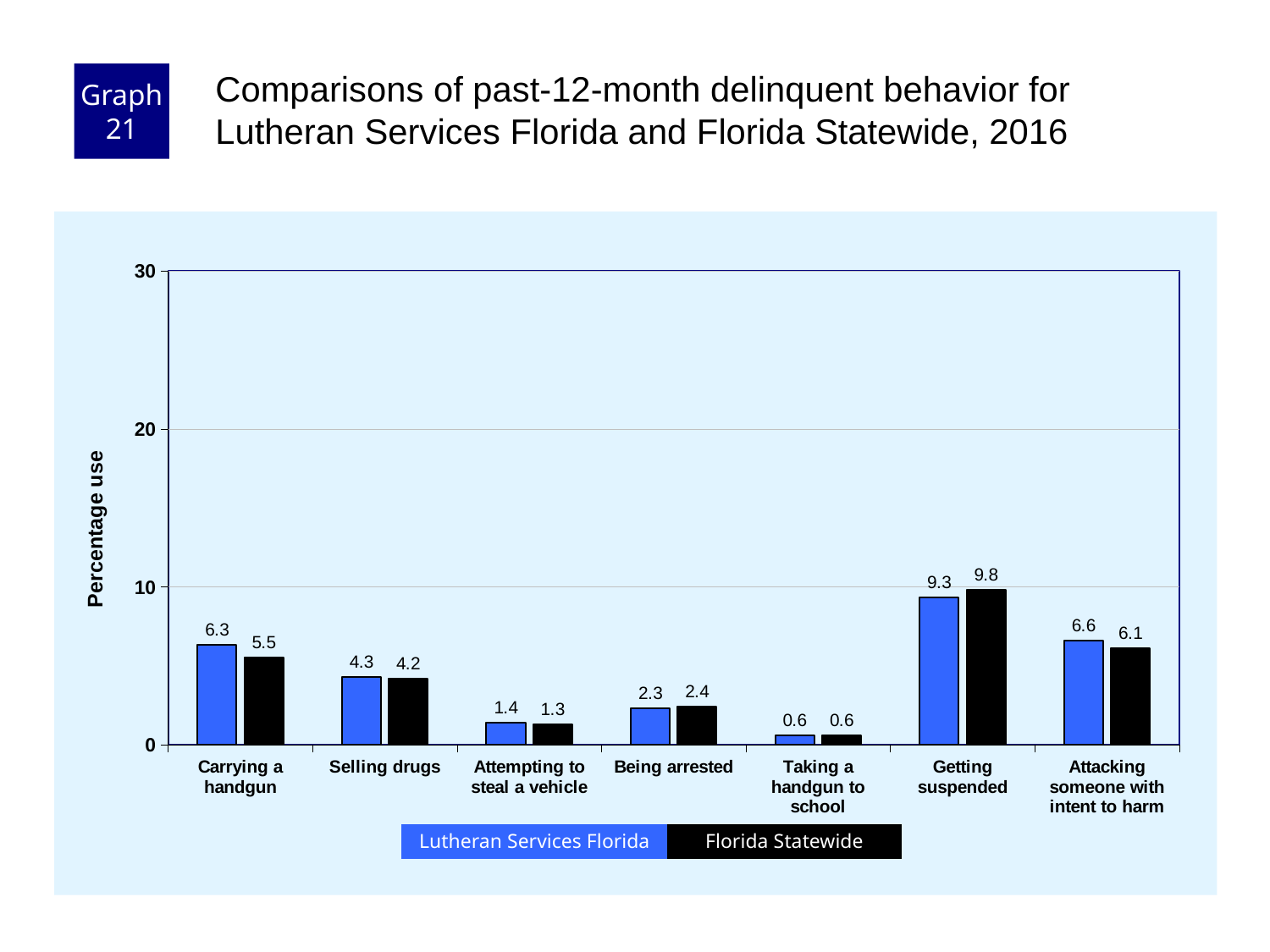
For Attacking someone with intent to harm, which is larger: Lutheran Services Florida or Florida Statewide? Lutheran Services Florida How many series does the legend list? 2 What is the Florida Statewide value for Carrying a handgun? 5.5 What is the Lutheran Services Florida value for Getting suspended? 9.3 What is the Lutheran Services Florida value for Attempting to steal a vehicle? 1.4 What is the difference between the Lutheran Services Florida and Florida Statewide values for Carrying a handgun? 0.8 What kind of chart is shown? bar chart Which category has the lowest Lutheran Services Florida value? Taking a handgun to school Is the Florida Statewide value for Getting suspended greater or less than 10? less Which category has the highest Florida Statewide value? Getting suspended How many categories are shown on the x axis? 7 What is the label of the y axis? Percentage use